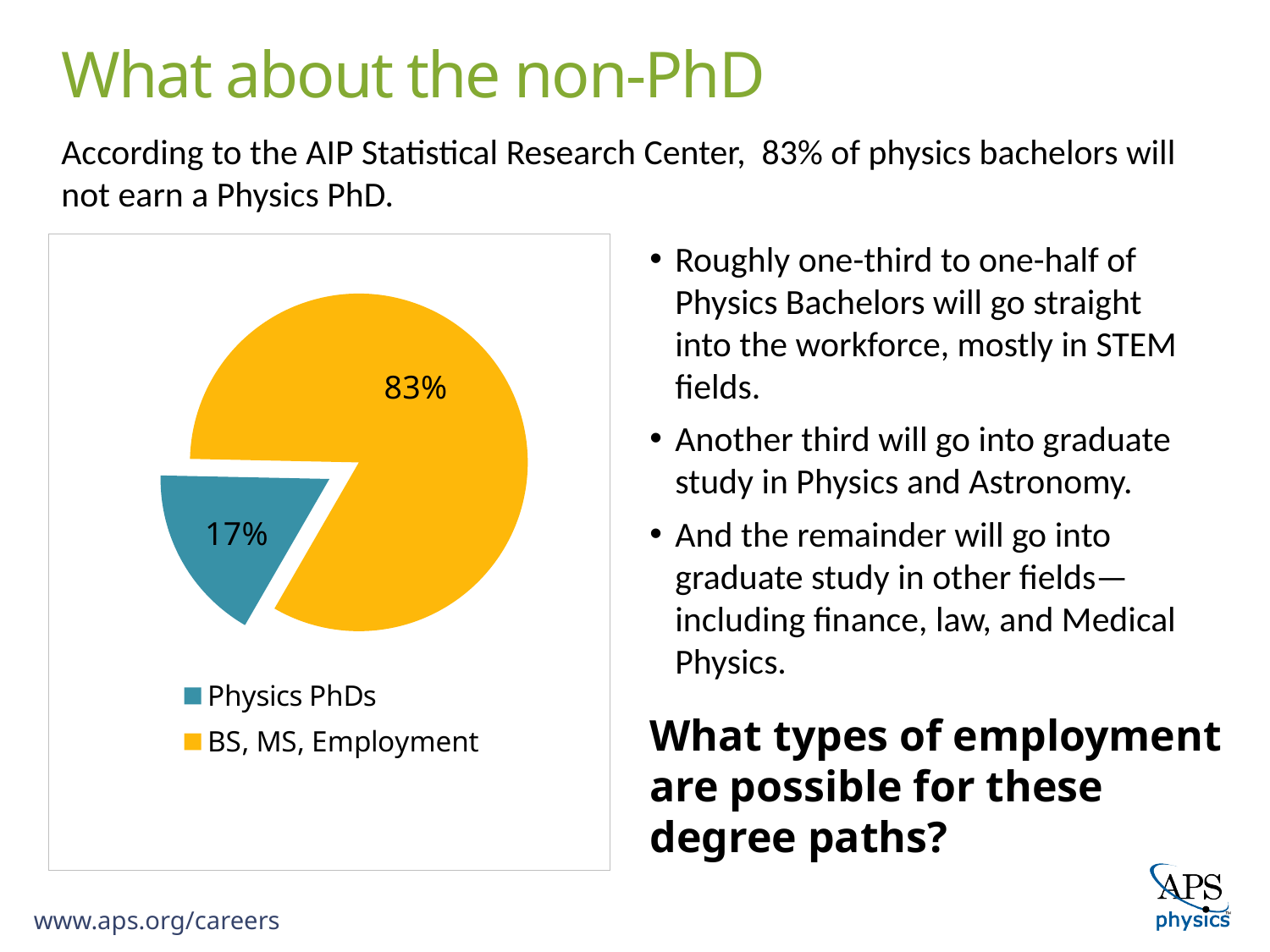
What colour is the "Physics PhDs" slice? teal blue What share of the pie is labelled "Physics PhDs"? 17% How many slices does the pie chart have? 2 How many entries does the legend list? 2 What type of chart is shown on the slide? pie chart What colour is the "BS, MS, Employment" slice? yellow Which is larger: the "Physics PhDs" slice or the "BS, MS, Employment" slice? BS, MS, Employment Which slice of the pie is the largest? BS, MS, Employment What share of the pie is labelled "BS, MS, Employment"? 83% Which slice of the pie is the smallest? Physics PhDs What is the difference in percentage points between the "BS, MS, Employment" slice and the "Physics PhDs" slice? 66